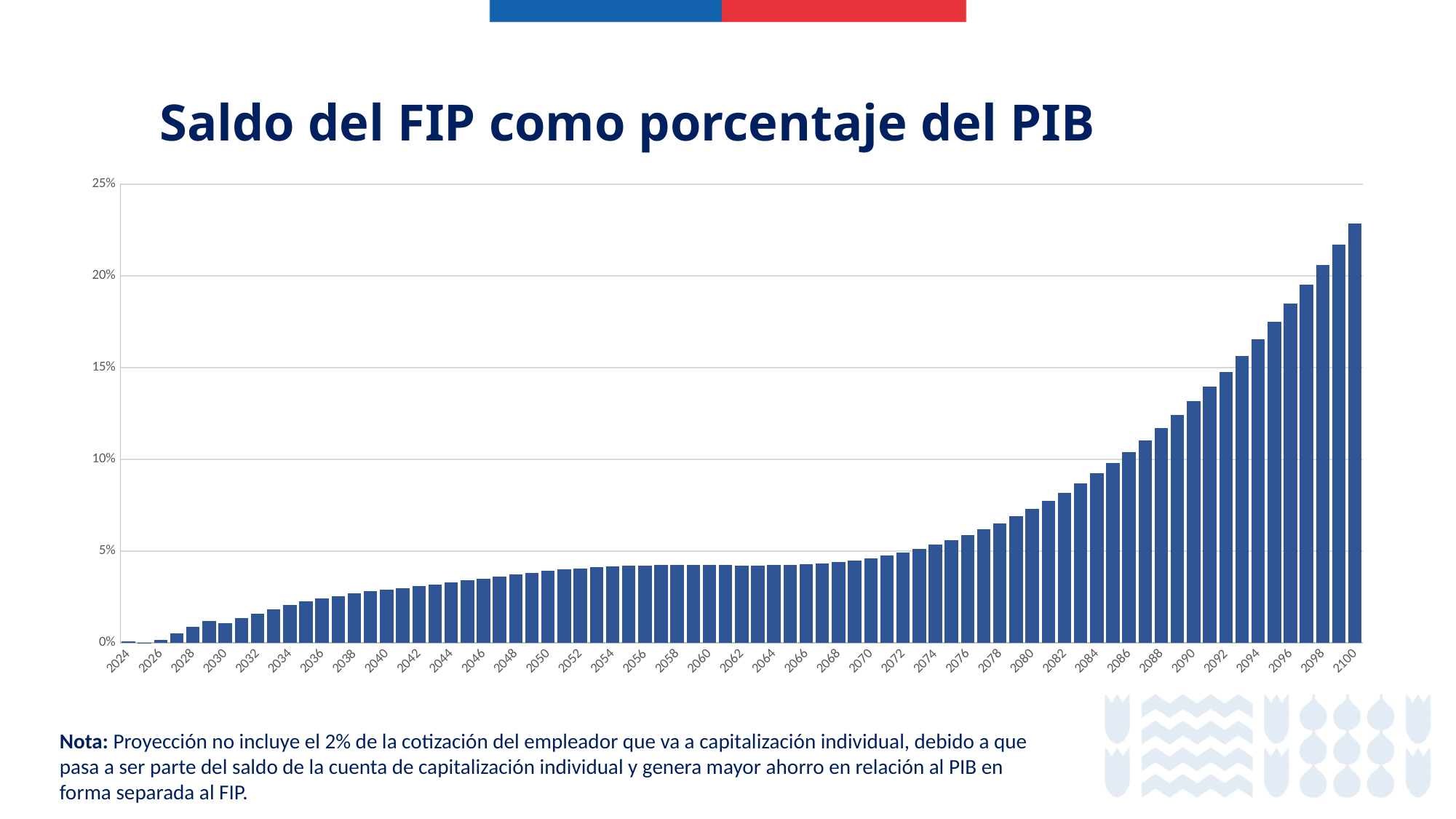
Is the value for 2096 greater or less than 20%? less What is the first year shown on the x axis? 2024 What kind of chart is shown on the slide? bar chart Is the value for 2090 greater or less than 10%? greater Which year has the larger value, 2030 or 2070? 2070 Is the value for 2100 greater or less than 20%? greater Do the values generally rise or fall from 2024 to 2100? rise Which year has the highest value in the chart? 2100 What is the title of the chart? Saldo del FIP como porcentaje del PIB